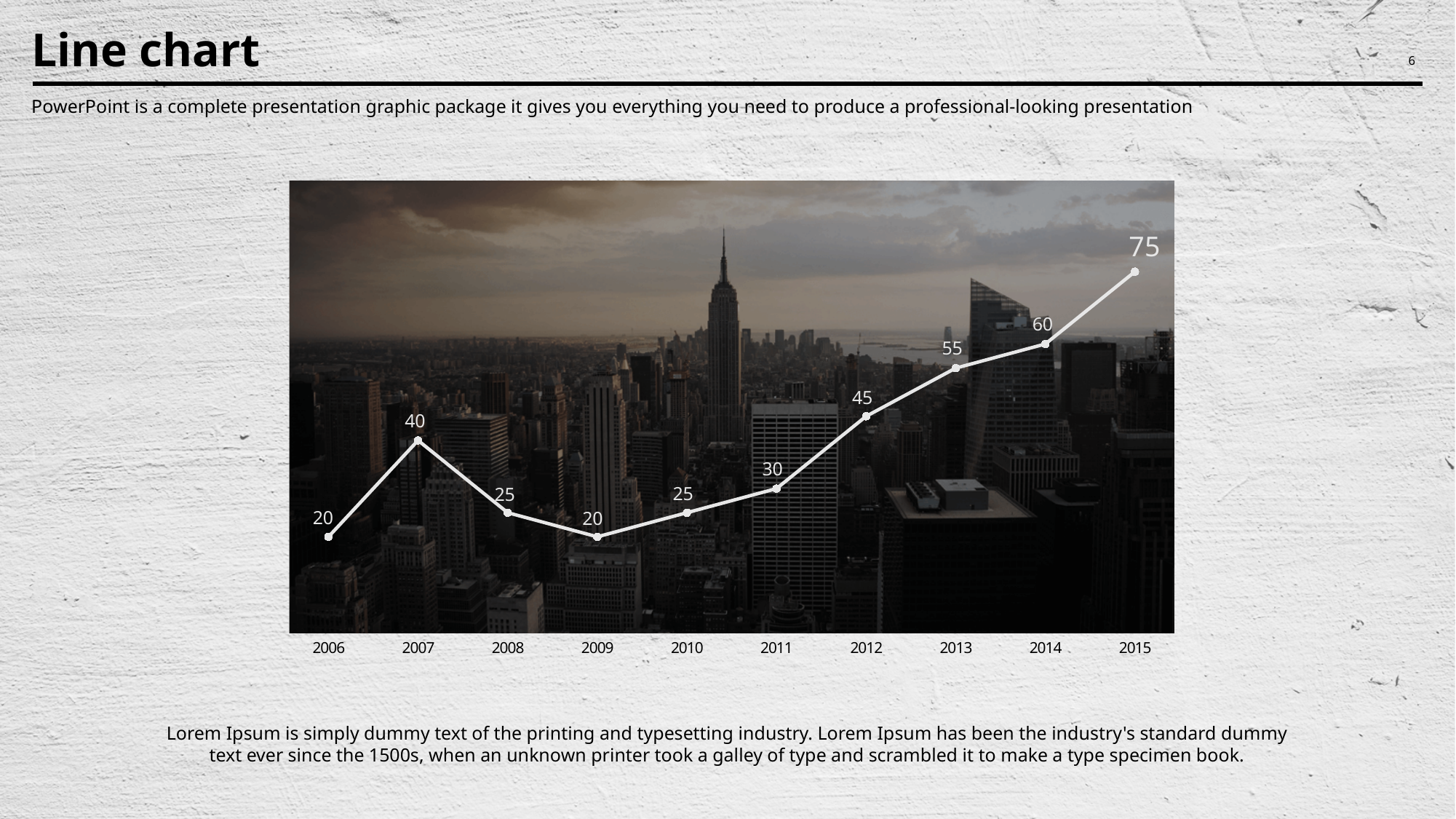
What is the title of the slide? Line chart What is the difference between the values for 2007 and 2008? 15 Which is larger, the value for 2012 or the value for 2010? 2012 What is the value for 2011? 30 How many years are plotted on the x axis? 10 What is the highest value shown on the chart? 75 What is the difference between the values for 2015 and 2014? 15 What kind of chart is shown on the slide? Line chart What is the value for 2007? 40 What is the value for 2013? 55 Do the values rise or fall from 2009 to 2015? Rise Which year has the highest value? 2015